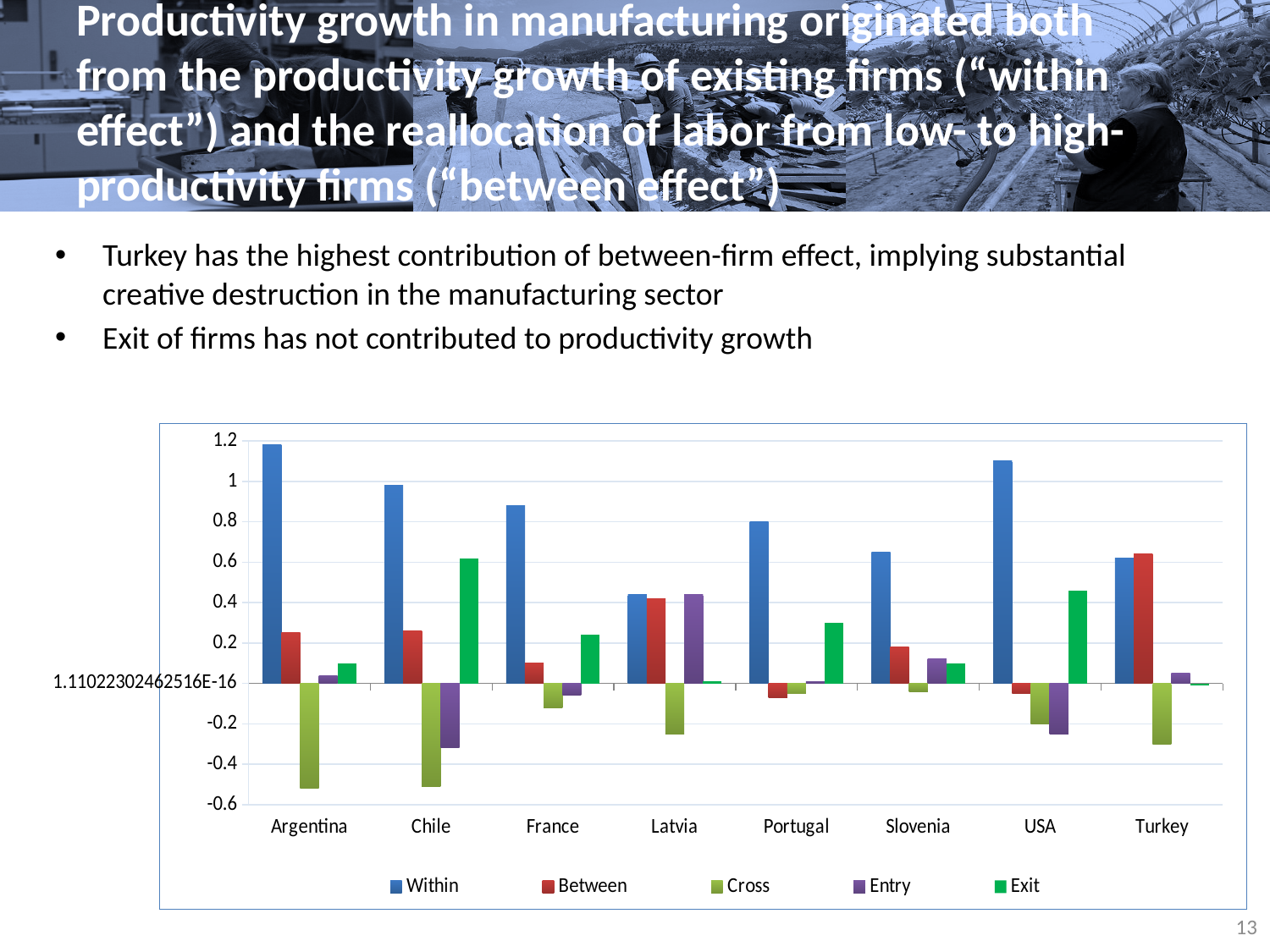
Is the Cross value for Argentina greater or less than -0.4? less Which is larger, the Within value for USA or the Within value for Chile? USA Which country has the lowest Entry value? Chile Which country has the highest Within value? Argentina Which country has the lowest Within value? Latvia How many countries are shown on the x axis of the chart? 8 Is the Within value for Argentina greater or less than 1? greater Which country has the highest Exit value? Chile Which country has the highest Between value? Turkey How many series does the chart's legend list? 5 What kind of chart is shown on the slide? bar chart Which series is shown in green in the chart's legend? Exit